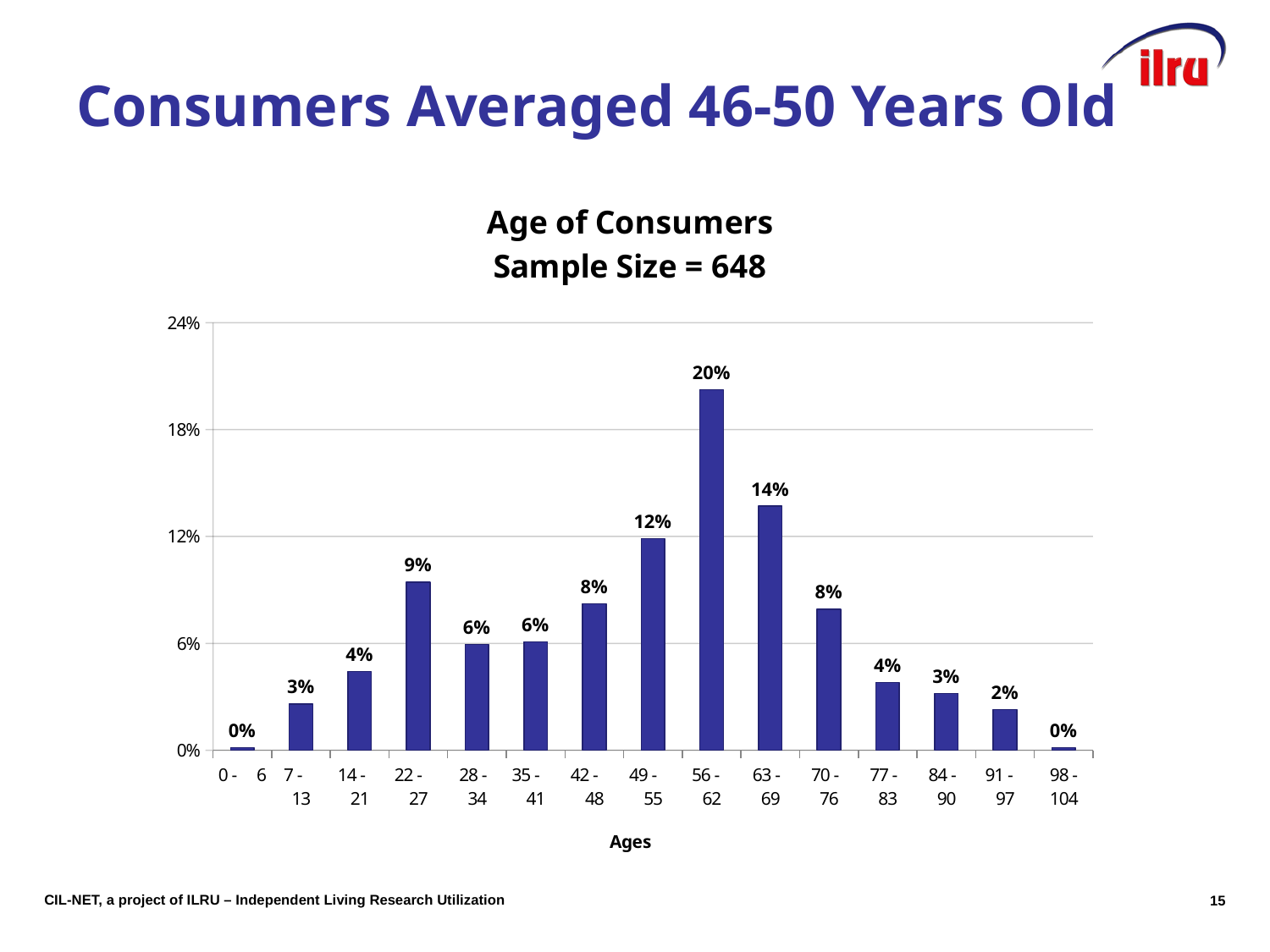
What is the difference in percentage points between the 49 - 55 and 42 - 48 age groups? 4% Which age group has a larger share of consumers, 14 - 21 or 70 - 76? 70 - 76 What percentage of consumers are in the 91 - 97 age group? 2% What is the difference in percentage points between the 56 - 62 and 63 - 69 age groups? 6% What percentage of consumers are in the 56 - 62 age group? 20% Is the value for the 63 - 69 age group greater or less than 12%? greater What kind of chart is shown on the slide? Bar chart What percentage of consumers are in the 22 - 27 age group? 9% How many age groups are shown on the x axis? 15 What sample size is stated in the chart title? 648 Which age group has the highest percentage of consumers? 56 - 62 Do the values rise or fall from the 56 - 62 age group to the 98 - 104 age group? Fall